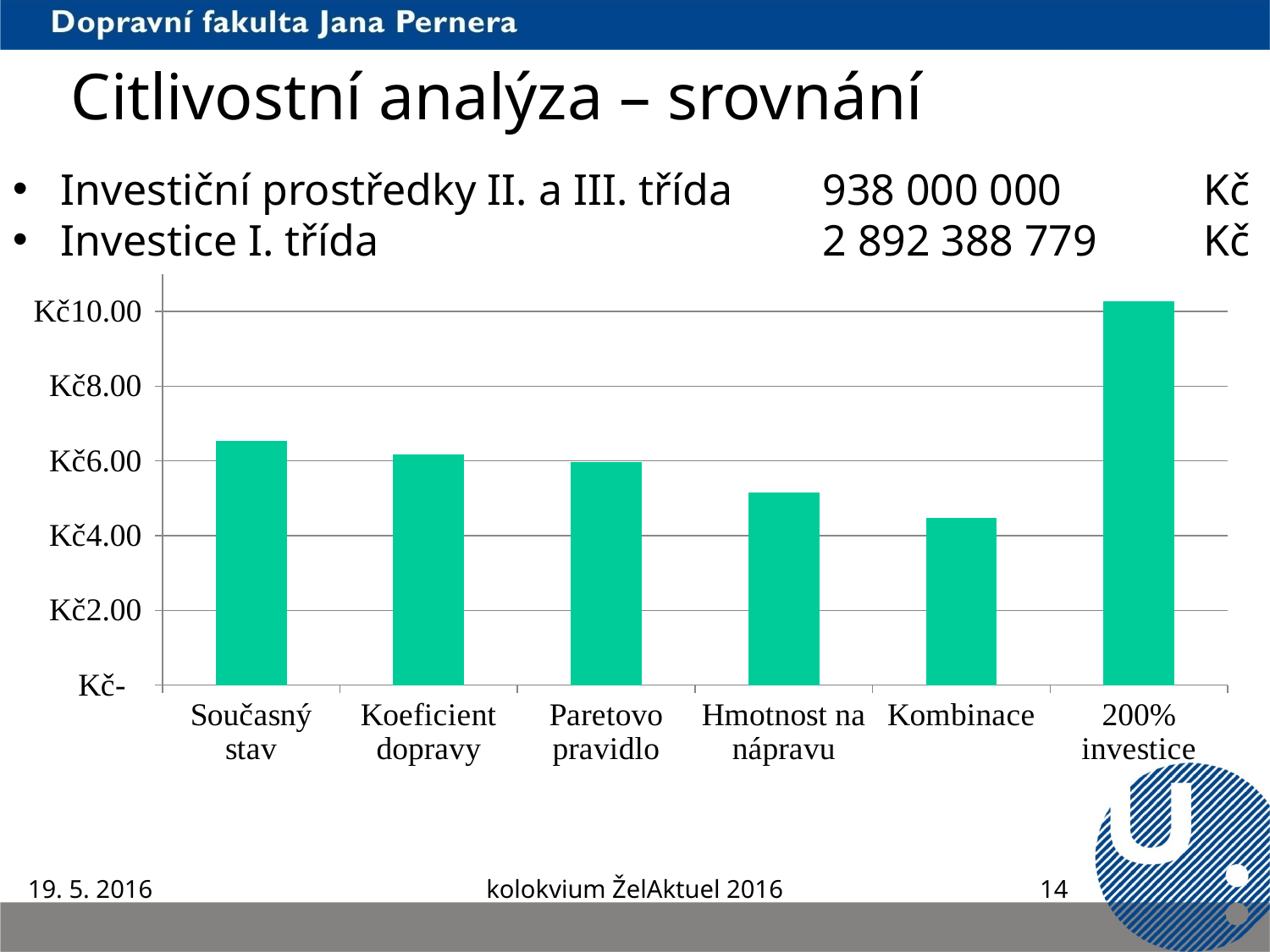
What kind of chart is shown on the slide? bar chart Is the value for Hmotnost na nápravu greater or less than Kč6.00? less Which category has the highest bar in the chart? 200% investice Is the value for 200% investice greater or less than Kč10.00? greater Which is larger, the value for Hmotnost na nápravu or the value for 200% investice? 200% investice What is the highest value labelled on the y axis of the chart? Kč10.00 Is the value for Kombinace greater or less than Kč6.00? less How many categories are shown on the x axis of the chart? 6 Which is larger, the value for Současný stav or the value for Kombinace? Současný stav Which category has the lowest bar in the chart? Kombinace